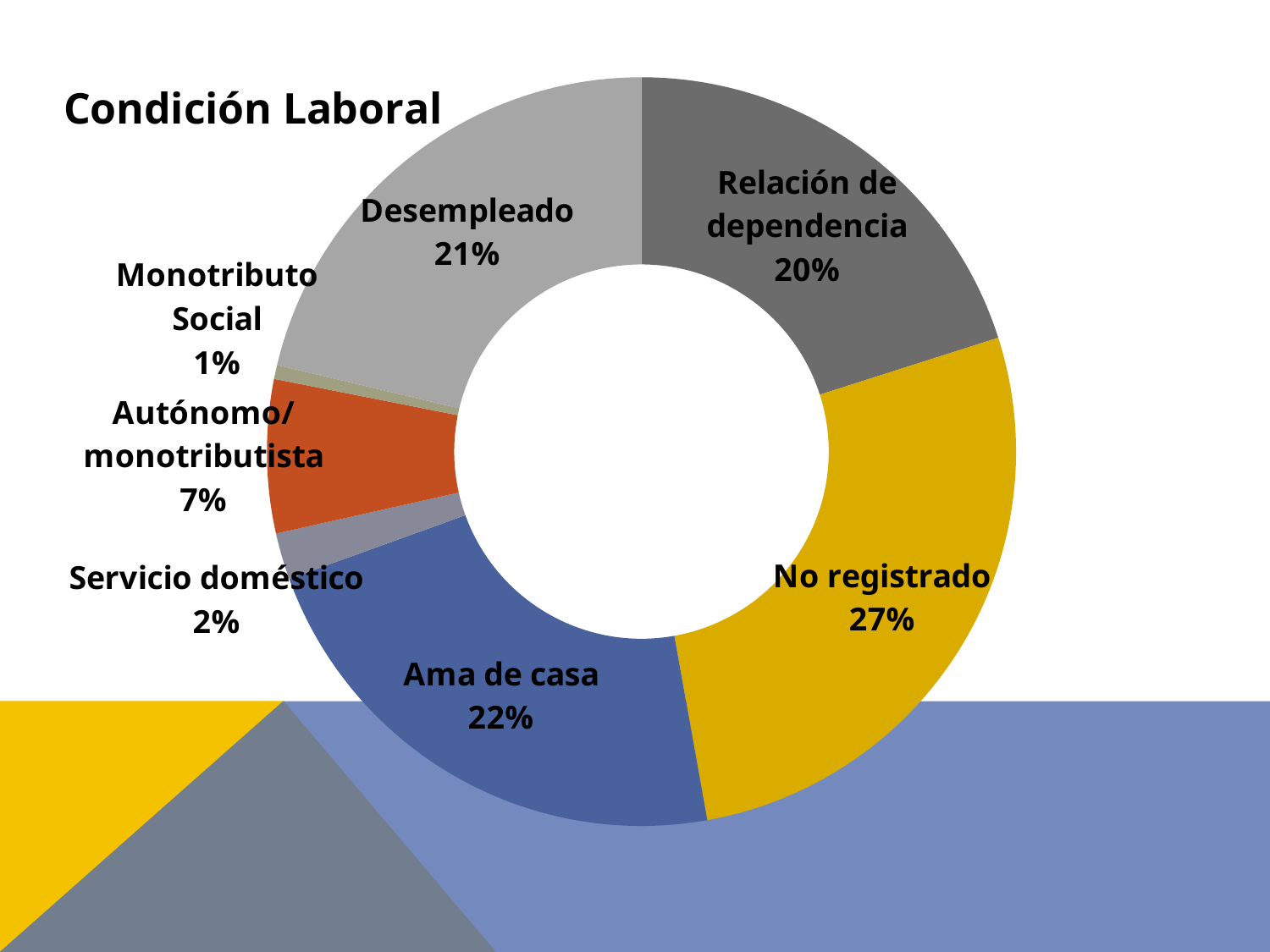
What percentage is shown for No registrado? 27% Which category has the smallest share? Monotributo Social Which category has the largest share? No registrado What percentage is shown for Ama de casa? 22% What is the difference in percentage points between No registrado and Desempleado? 6 Which is larger, Ama de casa or Relación de dependencia? Ama de casa What percentage is shown for Relación de dependencia? 20% What is the title of the chart? Condición Laboral How many categories are shown in the chart? 7 What percentage is shown for Autónomo/monotributista? 7% What kind of chart is shown on the slide? Doughnut (pie) chart What is the combined share of Servicio doméstico and Monotributo Social? 3%